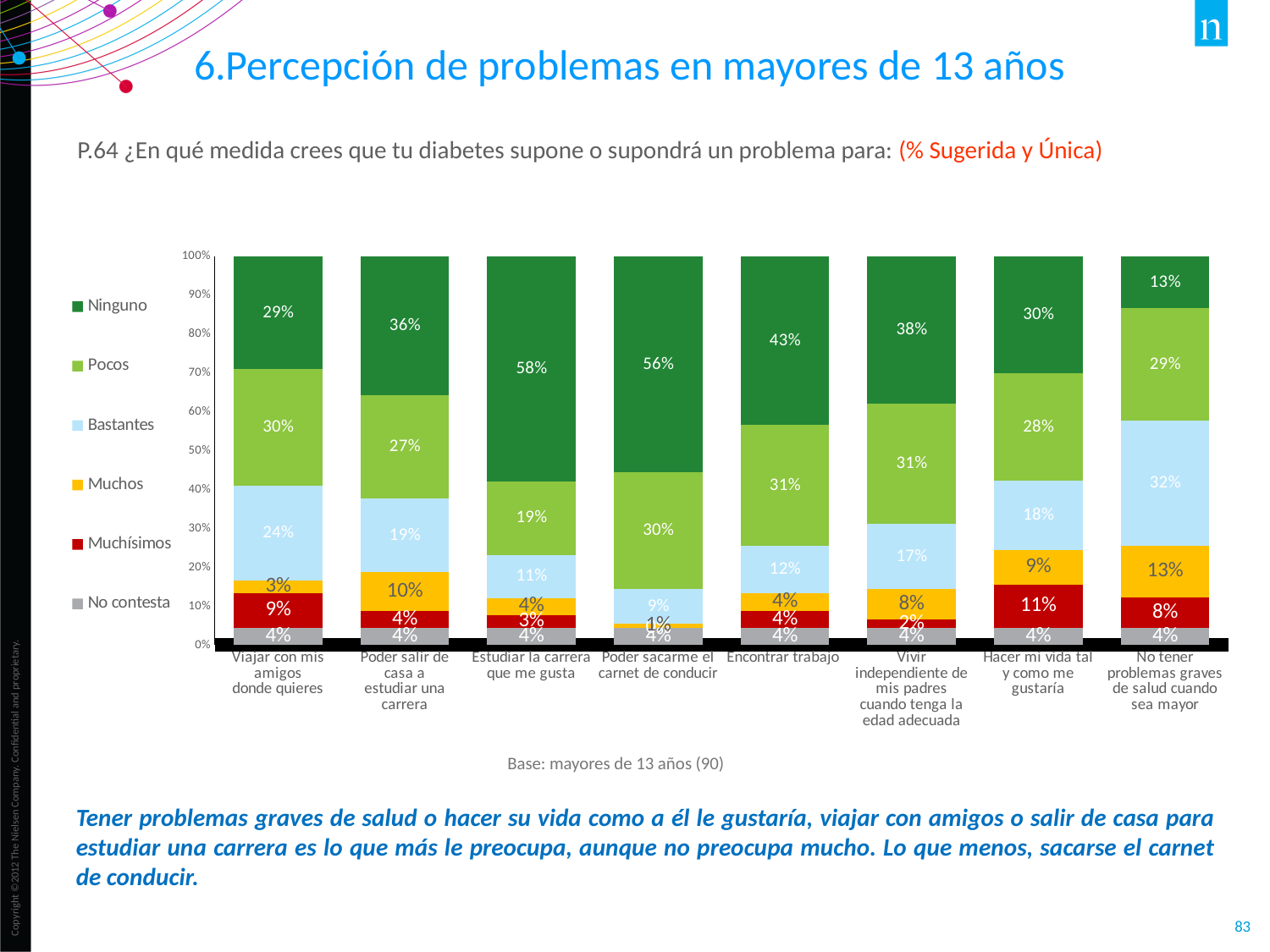
What is the 'Ninguno' value for 'Estudiar la carrera que me gusta'? 58% Which category has the lowest 'Ninguno' value? No tener problemas graves de salud cuando sea mayor What is the 'Muchísimos' value for 'Hacer mi vida tal y como me gustaría'? 11% Which is larger: the 'Pocos' value for 'Viajar con mis amigos donde quieres' or the 'Pocos' value for 'Poder salir de casa a estudiar una carrera'? Viajar con mis amigos donde quieres What is the 'Muchos' value for 'Poder salir de casa a estudiar una carrera'? 10% What is the 'Bastantes' value for 'No tener problemas graves de salud cuando sea mayor'? 32% What is the difference between the 'Ninguno' values for 'Encontrar trabajo' and 'Vivir independiente de mis padres cuando tenga la edad adecuada'? 5% What kind of chart is shown on the slide? Stacked bar chart Which category has the highest 'Ninguno' value? Estudiar la carrera que me gusta How many categories are plotted along the x axis? 8 How many series does the legend list? 6 Which legend entry is shown in dark green? Ninguno